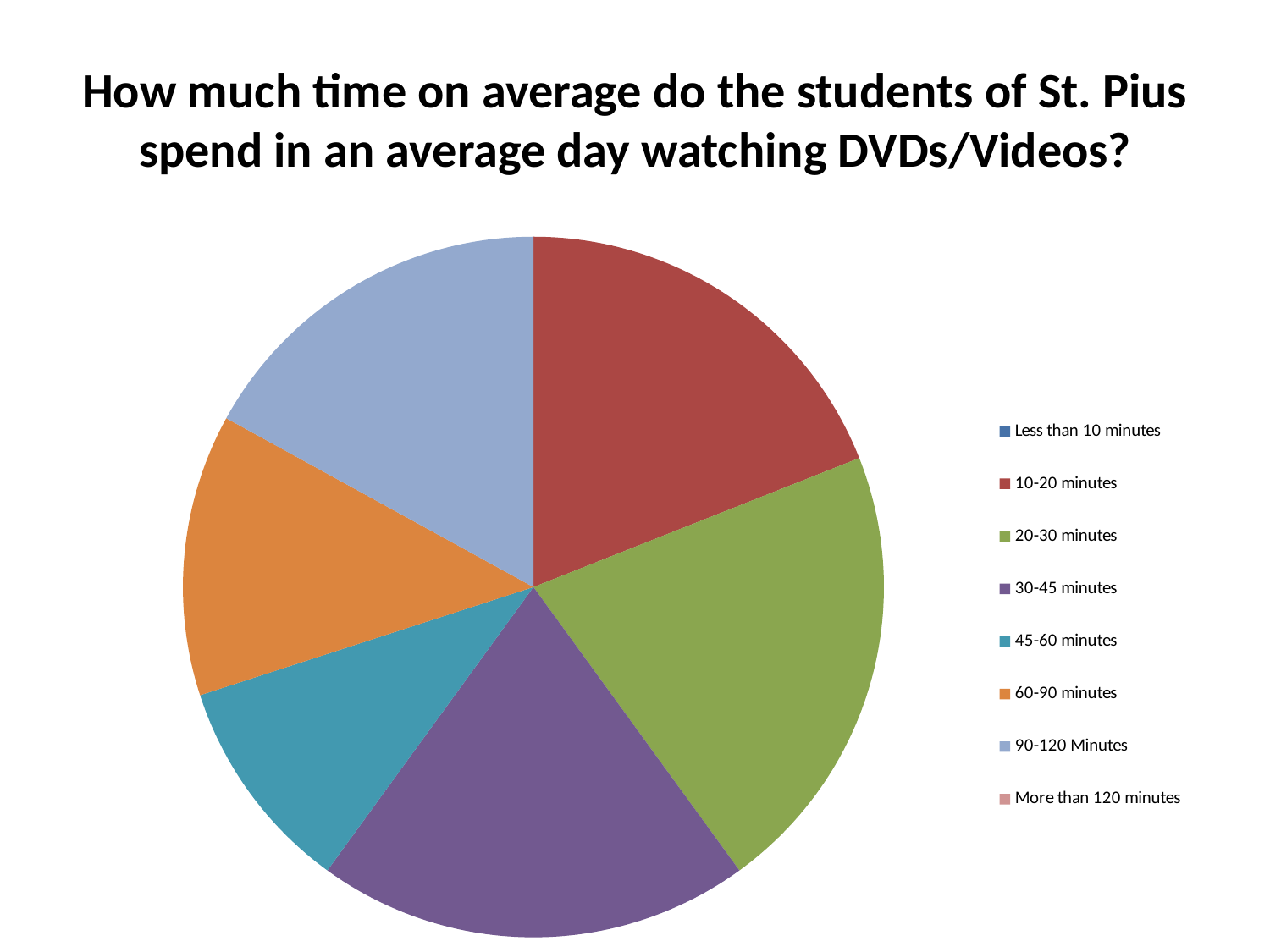
What is the title of the chart? How much time on average do the students of St. Pius spend in an average day watching DVDs/Videos? Is the share of the pie for 20-30 minutes greater or less than 50%? less What colour is the 60-90 minutes slice? orange How many slices are visible in the pie? 6 Which slice is larger, 45-60 minutes or 60-90 minutes? 60-90 minutes Which slice is larger, 90-120 Minutes or 45-60 minutes? 90-120 Minutes What kind of chart is shown on the slide? pie chart Is the share of the pie for 45-60 minutes greater or less than 25%? less Which slice is larger, 45-60 minutes or 20-30 minutes? 20-30 minutes Which of the visible slices is the smallest? 45-60 minutes How many categories does the legend list? 8